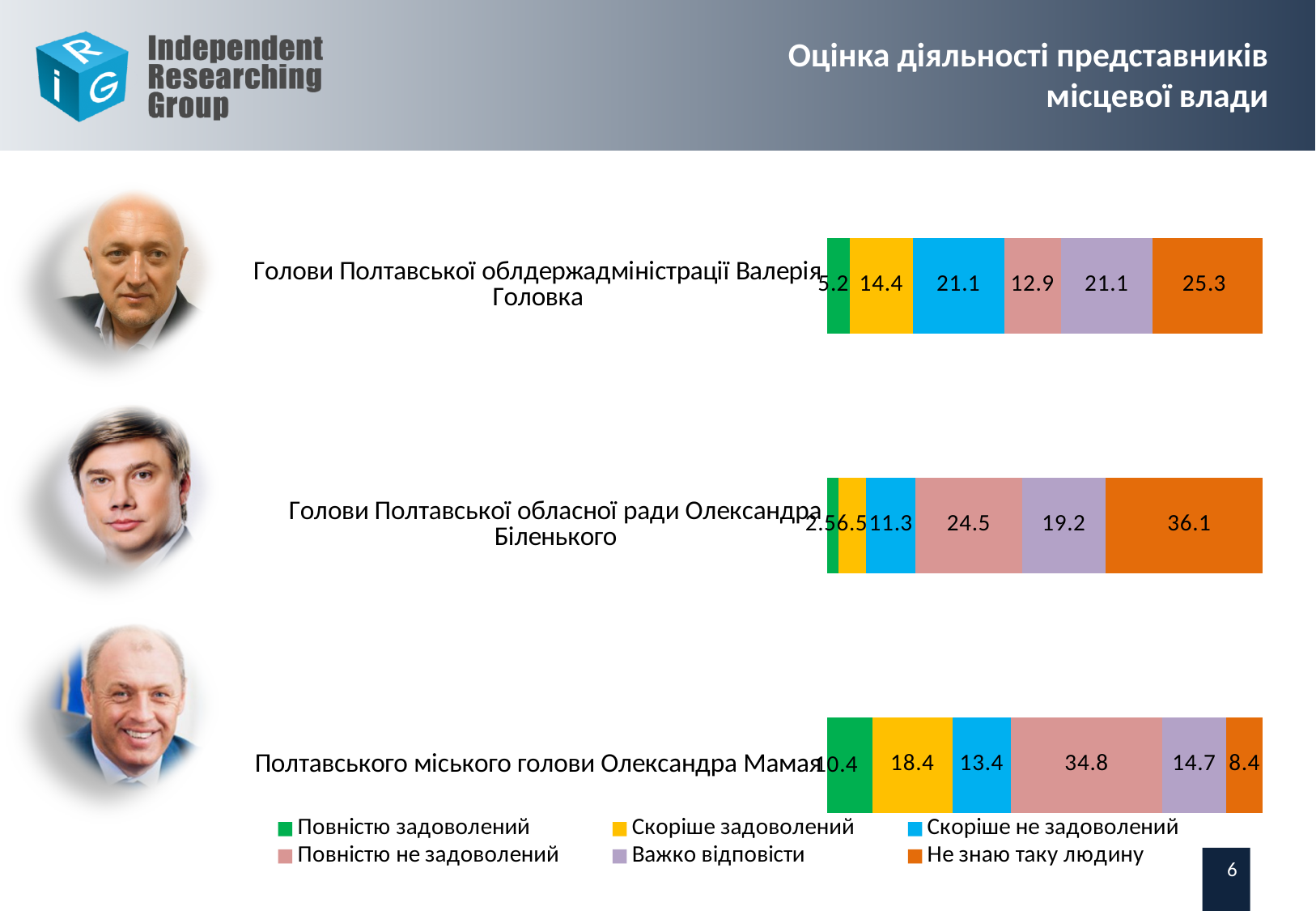
Which official has the lowest value for "Не знаю таку людину"? Полтавського міського голови Олександра Мамая What is the difference between the "Скоріше задоволений" values for Олександра Мамая and Валерія Головка? 4.0 How many series does the legend list? 6 What kind of chart is shown on the slide? Stacked bar chart What is the value of "Повністю не задоволений" for Полтавського міського голови Олександра Мамая? 34.8 Which is larger: the "Важко відповісти" value for Валерія Головка or for Олександра Біленького? Валерія Головка What is the value of "Повністю задоволений" for Голови Полтавської облдержадміністрації Валерія Головка? 5.2 What is the value of "Скоріше не задоволений" for Голови Полтавської обласної ради Олександра Біленького? 11.3 How many officials (categories) are shown in the chart? 3 Which official has the highest value for "Повністю задоволений"? Полтавського міського голови Олександра Мамая What colour represents "Не знаю таку людину" in the chart? Orange What is the value of "Не знаю таку людину" for Голови Полтавської обласної ради Олександра Біленького? 36.1